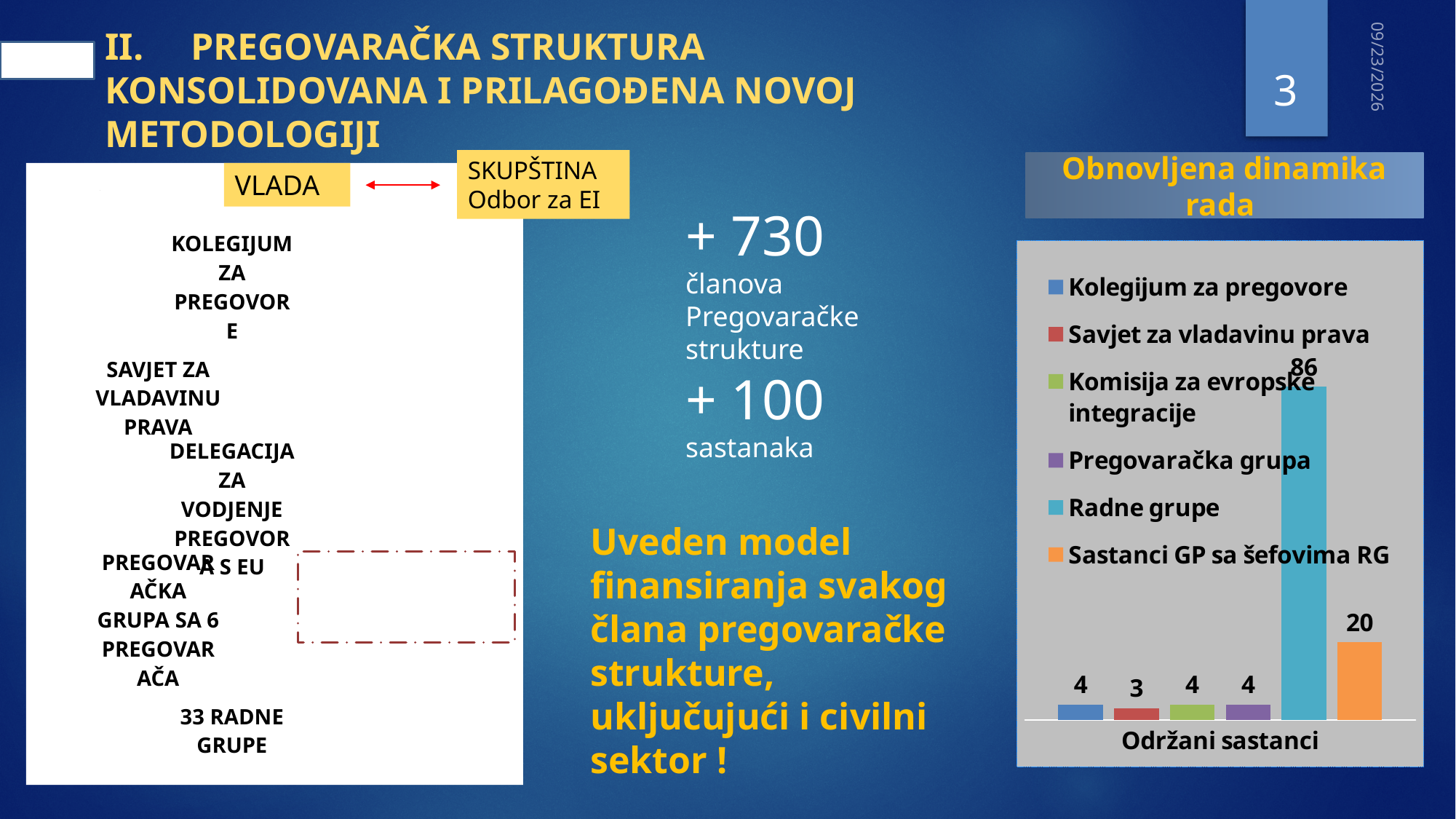
What is the category label shown on the x axis of the chart? Održani sastanci What is the value for Sastanci GP sa šefovima RG in the chart? 20 What type of chart is shown under the heading "Obnovljena dinamika rada"? bar chart Which series has the highest value in the chart? Radne grupe Which series has the lowest value in the chart? Savjet za vladavinu prava What is the value for Savjet za vladavinu prava in the chart? 3 What is the value for Radne grupe in the chart? 86 What colour is the bar for Radne grupe in the chart? light blue What is the difference between the values for Radne grupe and Sastanci GP sa šefovima RG? 66 What is the value for Kolegijum za pregovore in the chart? 4 Which is larger in the chart: Sastanci GP sa šefovima RG or Pregovaračka grupa? Sastanci GP sa šefovima RG How many series does the legend of the chart list? 6